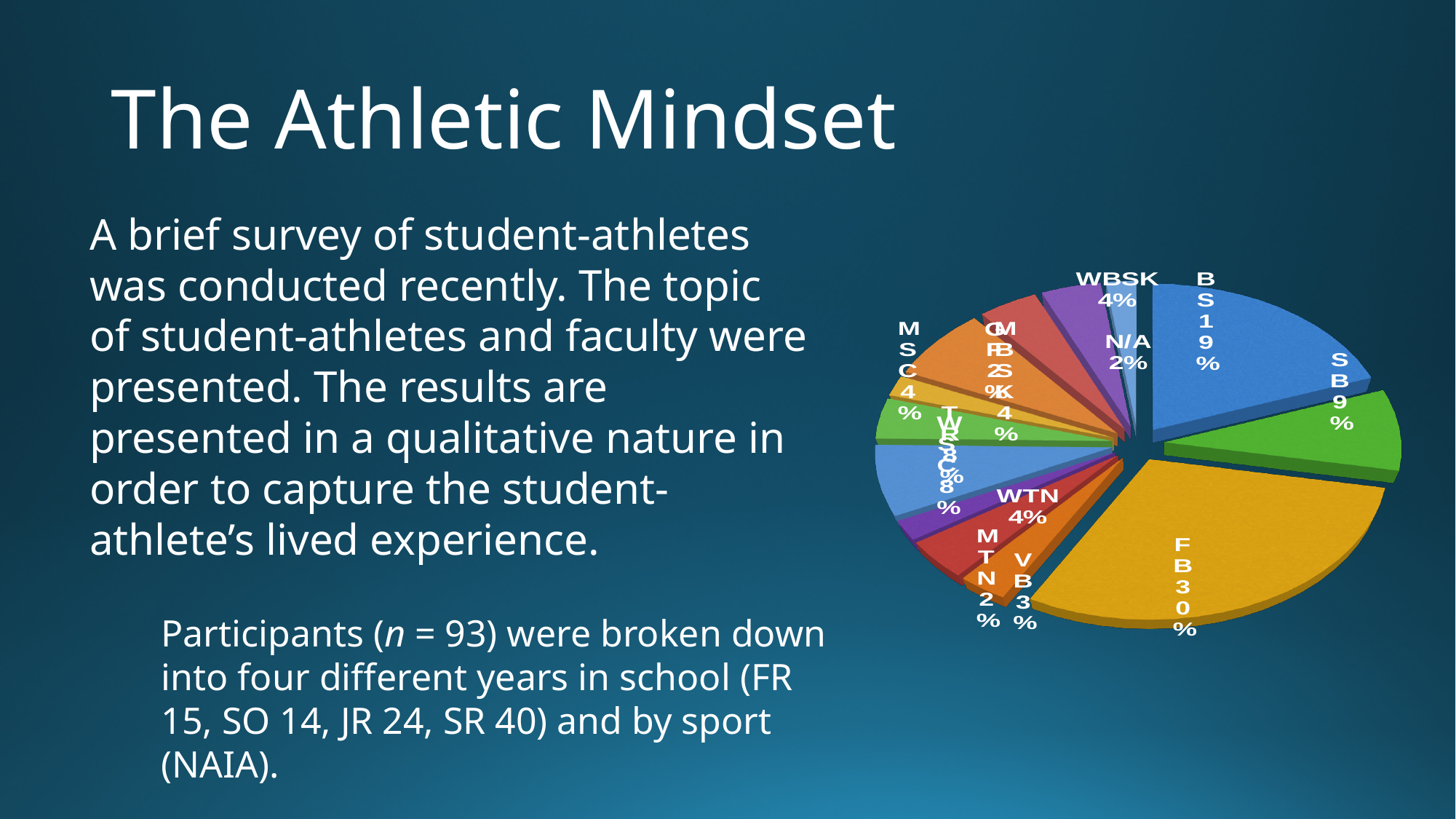
What percentage is shown for SB in the pie chart? 9% Which slice is larger in the pie chart, FB or SB? FB What percentage is shown for VB in the pie chart? 3% What kind of chart is shown on the slide? pie chart What percentage is shown for N/A in the pie chart? 2% What percentage is shown for MSC in the pie chart? 4% Which category has the largest slice of the pie chart? FB What percentage is shown for FB in the pie chart? 30% What percentage is shown for WTN in the pie chart? 4% What is the difference in percentage points between the FB slice and the SB slice? 21% What percentage is shown for MTN in the pie chart? 2% What percentage is shown for WBSK in the pie chart? 4%